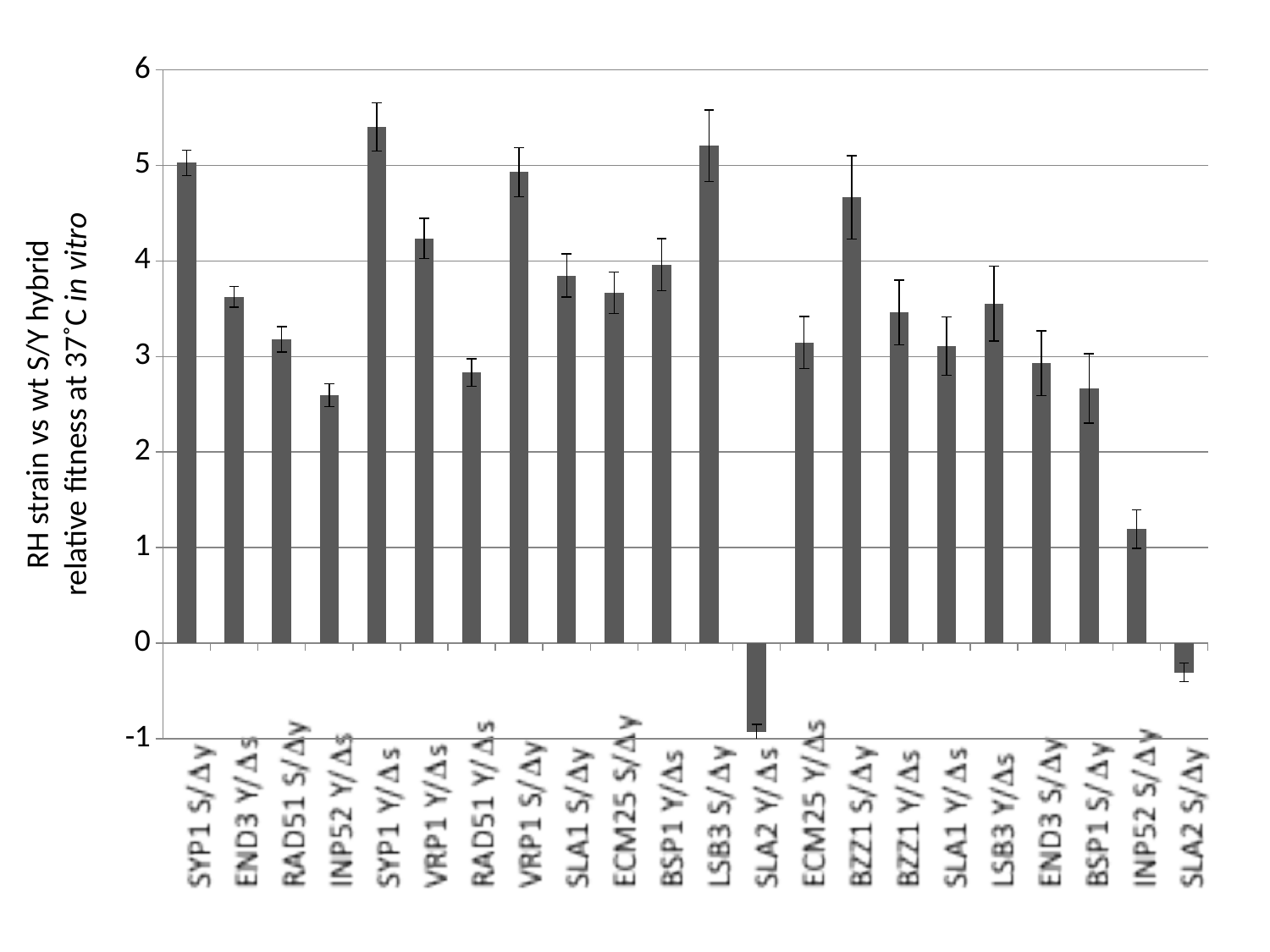
Is the value for BZZ1 S/Δy greater or less than 4? greater What kind of chart is shown on the slide? bar chart Is the value for INP52 S/Δy greater or less than 2? less Which is larger, the value for SYP1 Y/Δs or the value for INP52 Y/Δs? SYP1 Y/Δs What is the label of the vertical axis? RH strain vs wt S/Y hybrid relative fitness at 37°C in vitro How many bars (categories) are plotted in the chart? 22 Is the value for SLA2 Y/Δs greater or less than 0? less Which category has the lowest value in the chart? SLA2 Y/Δs Which is larger, the value for BZZ1 S/Δy or the value for BZZ1 Y/Δs? BZZ1 S/Δy How many bars in the chart have a negative value? 2